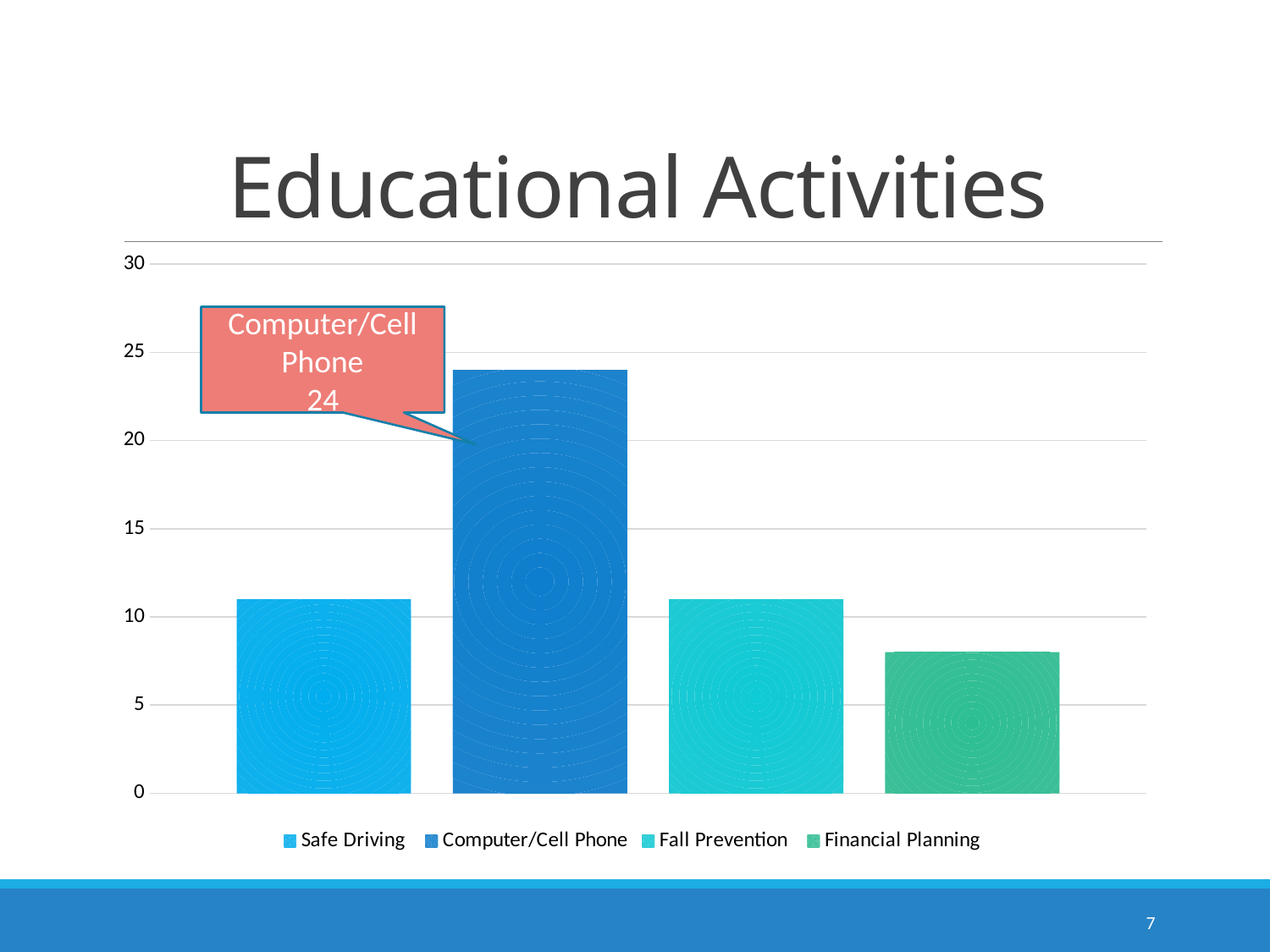
How many entries does the legend list? 4 Is the value for Fall Prevention greater or less than 15? less Which category has the lowest value? Financial Planning How many bars are shown in the chart? 4 What is the value for Computer/Cell Phone? 24 Is the value for Financial Planning greater or less than 10? less Which is larger, the value for Computer/Cell Phone or the value for Financial Planning? Computer/Cell Phone Which is larger, the value for Safe Driving or the value for Financial Planning? Safe Driving Is the value for Computer/Cell Phone greater or less than 20? greater What kind of chart is shown on the slide? bar chart Which category has the highest value? Computer/Cell Phone